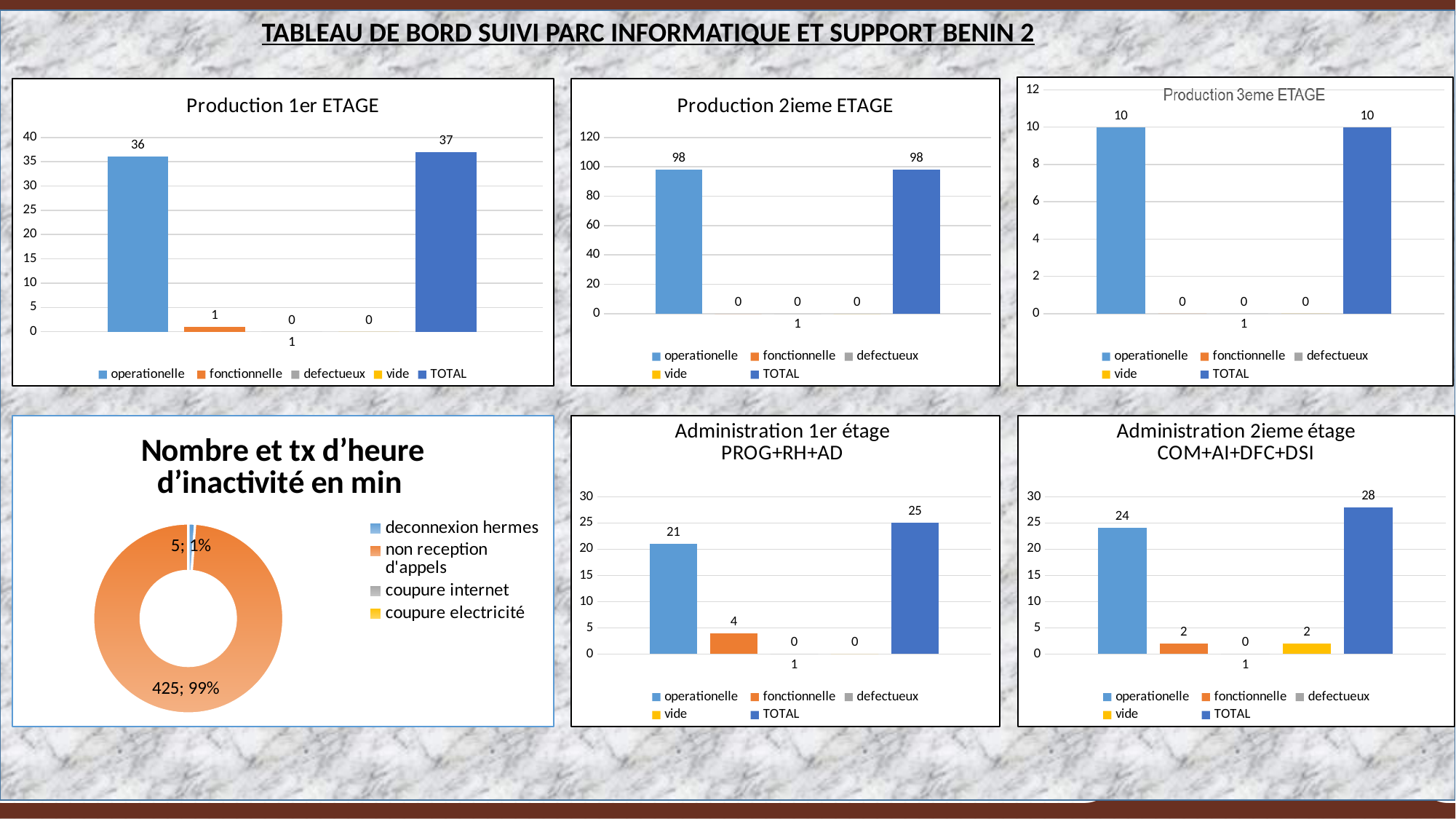
In the 'Production 2ieme ETAGE' chart, what is the value for operationelle? 98 How many series does the legend of the 'Production 2ieme ETAGE' chart list? 5 In the donut chart 'Nombre et tx d'heure d'inactivité en min', what share does non reception d'appels have? 99% In the 'Production 1er ETAGE' chart, what is the value for operationelle? 36 In the donut chart 'Nombre et tx d'heure d'inactivité en min', what is the value for deconnexion hermes? 5 In the 'Administration 2ieme étage COM+AI+DFC+DSI' chart, which series has the highest value? TOTAL In the 'Administration 1er étage PROG+RH+AD' chart, what is the value for fonctionnelle? 4 In the 'Production 3eme ETAGE' chart, what is the value for TOTAL? 10 In the 'Administration 2ieme étage COM+AI+DFC+DSI' chart, is the value for operationelle greater or less than 20? greater In the 'Administration 2ieme étage COM+AI+DFC+DSI' chart, what is the value for vide? 2 In the 'Production 1er ETAGE' chart, what is the value for TOTAL? 37 In the 'Administration 1er étage PROG+RH+AD' chart, what is the difference between TOTAL and operationelle? 4